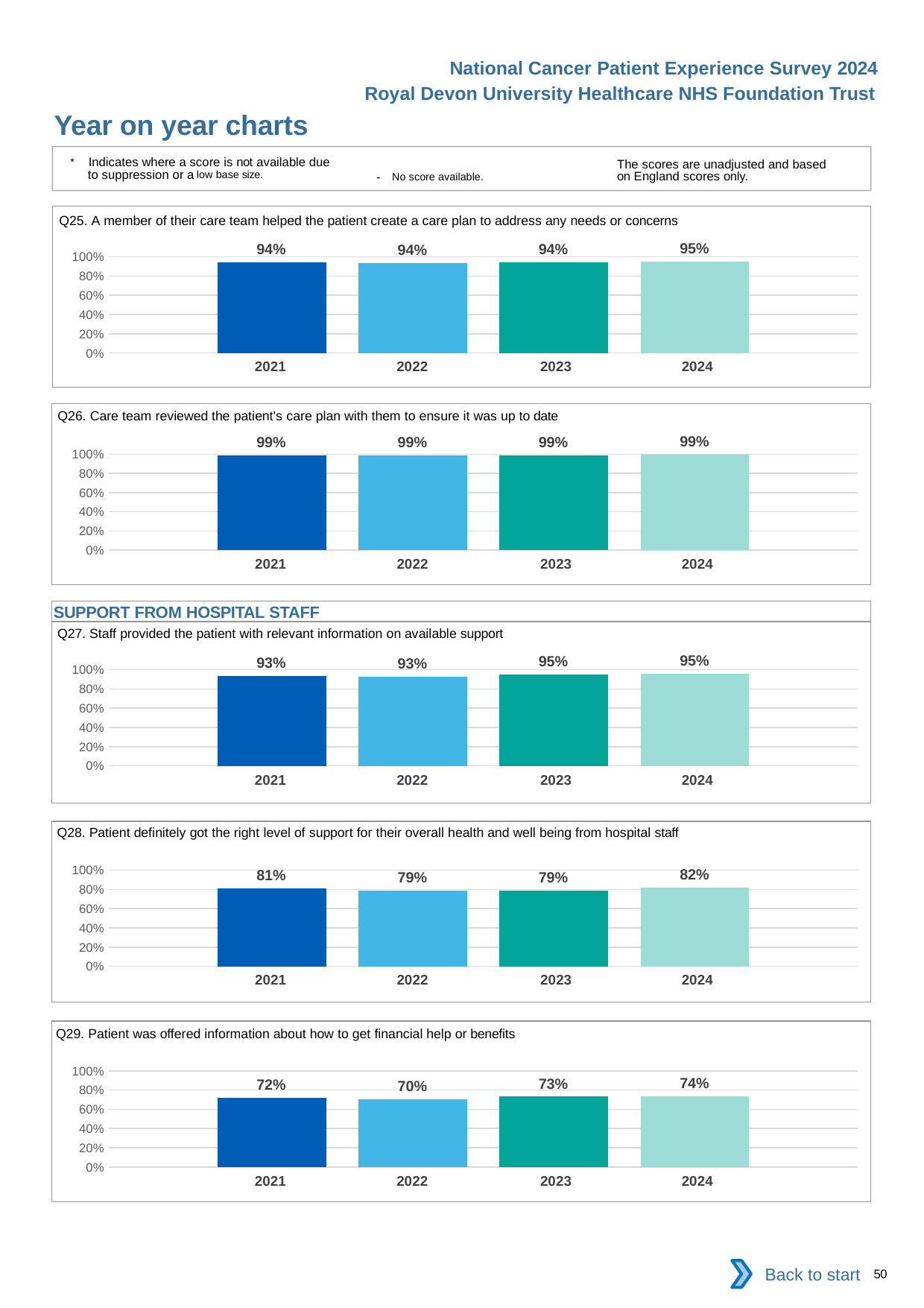
In the Q29 chart (information about financial help or benefits), which year has the lowest value? 2022 In the Q26 chart (care team reviewed the care plan), what is the value for 2021? 99% In the Q25 chart (care team helped create a care plan), what is the value for 2024? 95% In the Q29 chart (information about financial help or benefits), what is the value for 2023? 73% In the Q29 chart (information about financial help or benefits), is the value for 2024 greater or less than 80%? less In the Q28 chart (right level of support from hospital staff), which year has the highest value? 2024 What kind of chart is used for Q27 (staff provided relevant information on available support)? bar chart In the Q28 chart (right level of support from hospital staff), what is the difference between the 2024 and 2023 values? 3 percentage points In the Q27 chart (staff provided relevant information on available support), what is the difference between the 2024 and 2021 values? 2 percentage points What is the section heading shown above the Q27 chart? SUPPORT FROM HOSPITAL STAFF How many years are plotted in the Q25 chart? 4 In the Q28 chart (right level of support from hospital staff), is the value for 2022 larger or smaller than the value for 2021? smaller